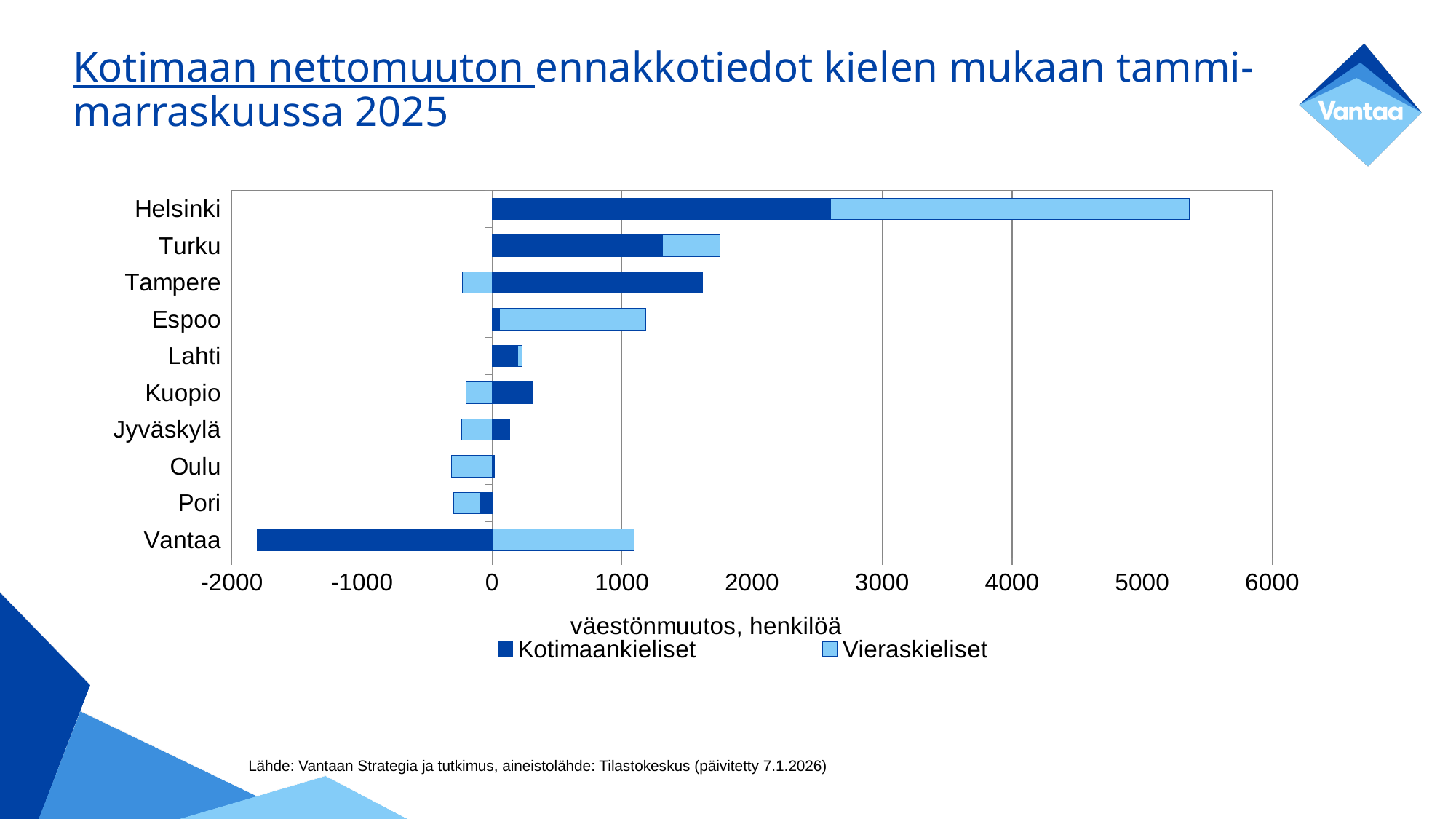
What kind of chart is shown on the slide? bar chart Is the Kotimaankieliset value for Vantaa greater or less than -1000? less What is the title of the horizontal axis of the chart? väestönmuutos, henkilöä Is the Vieraskieliset value for Tampere greater or less than 0? less Which city has the highest value for Kotimaankieliset? Helsinki Which city has the larger Kotimaankieliset value, Turku or Tampere? Tampere Which city has the lowest value for Kotimaankieliset? Vantaa Which city has the larger Vieraskieliset value, Helsinki or Espoo? Helsinki Is the Kotimaankieliset value for Tampere greater or less than 1000? greater How many series does the chart legend list? 2 How many cities are listed on the vertical axis of the chart? 10